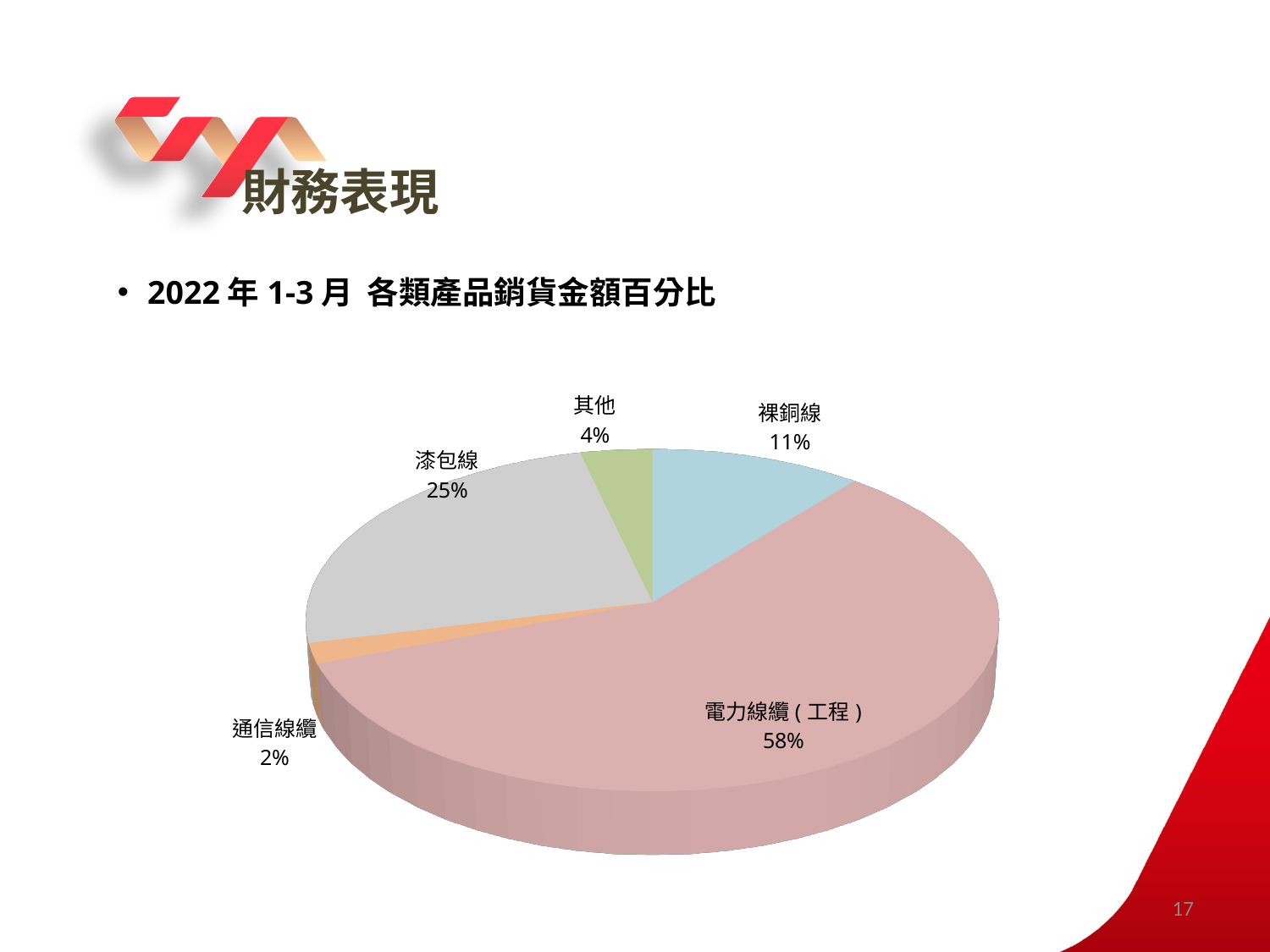
What is the value shown for 其他? 4% Which is larger, the share for 裸銅線 or the share for 其他? 裸銅線 What is the value shown for 通信線纜? 2% Which category has the largest share of the pie? 電力線纜 ( 工程 ) What period does the chart's heading say the sales percentages cover? 2022 年 1-3 月 What is the value shown for 裸銅線? 11% What is the difference in percentage points between 電力線纜 ( 工程 ) and 漆包線? 33% What share of the pie does 電力線纜 ( 工程 ) represent? 58% What kind of chart is shown on the slide? pie chart What is the value shown for 漆包線? 25% How many slices does the pie chart have? 5 Which category has the smallest share of the pie? 通信線纜